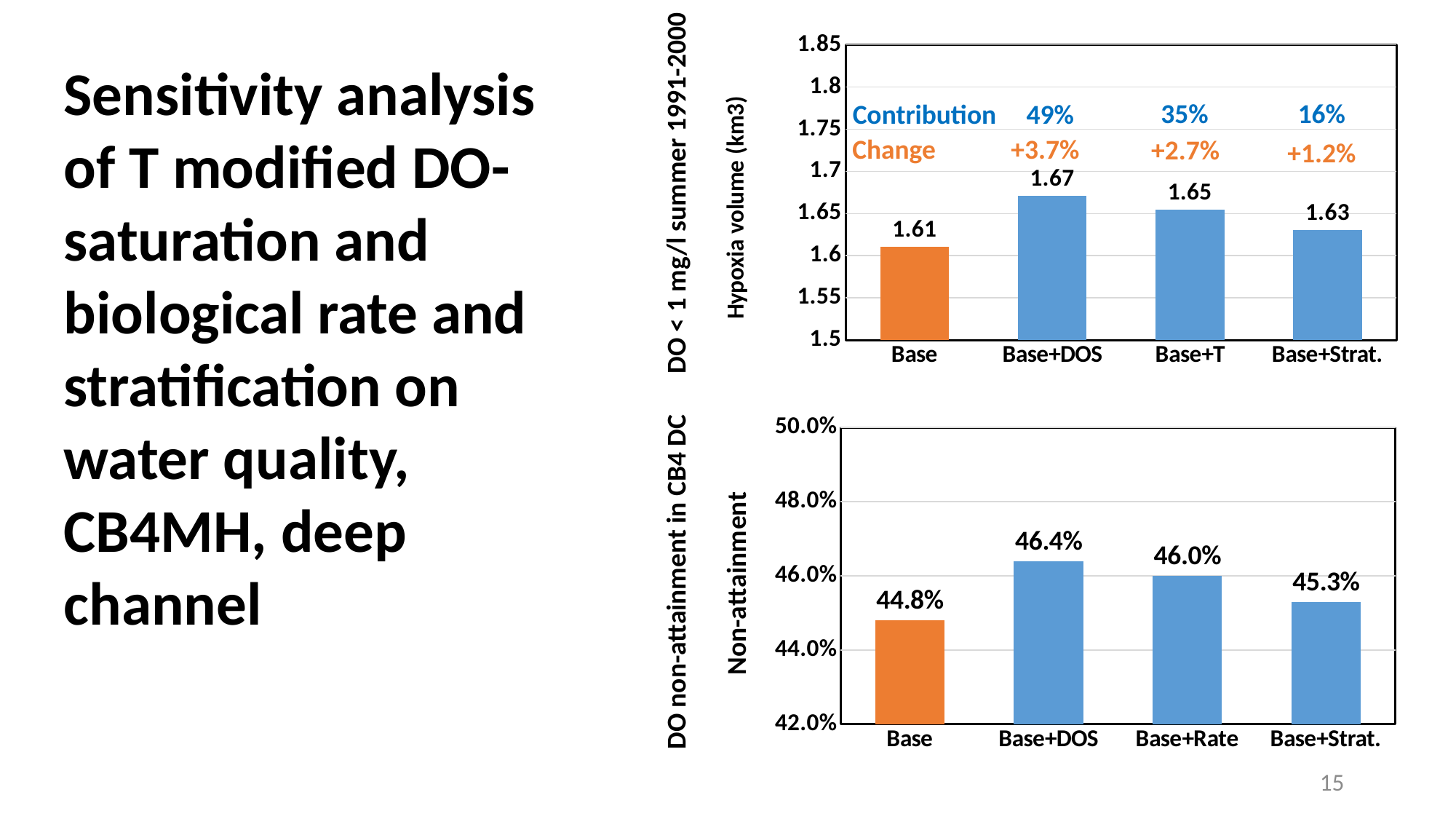
In the top chart (Hypoxia volume), which category has the highest value? Base+DOS In the bottom chart (Non-attainment), what is the value for Base+Strat.? 45.3% In the bottom chart (Non-attainment), is the value for Base greater or less than 46.0%? less In the top chart (Hypoxia volume), which category has the lowest value? Base In the top chart (Hypoxia volume), what is the difference between Base+DOS and Base? 0.06 In the bottom chart (Non-attainment), which category has the highest value? Base+DOS How many categories are shown in the bottom chart (Non-attainment)? 4 In the bottom chart (Non-attainment), what is the difference between Base+DOS and Base? 1.6% In the top chart (Hypoxia volume), what is the value for Base? 1.61 In the bottom chart (Non-attainment), what is the value for Base+Rate? 46.0% In the top chart (Hypoxia volume), what is the value for Base+DOS? 1.67 In the top chart (Hypoxia volume), what contribution percentage is shown above Base+T? 35%